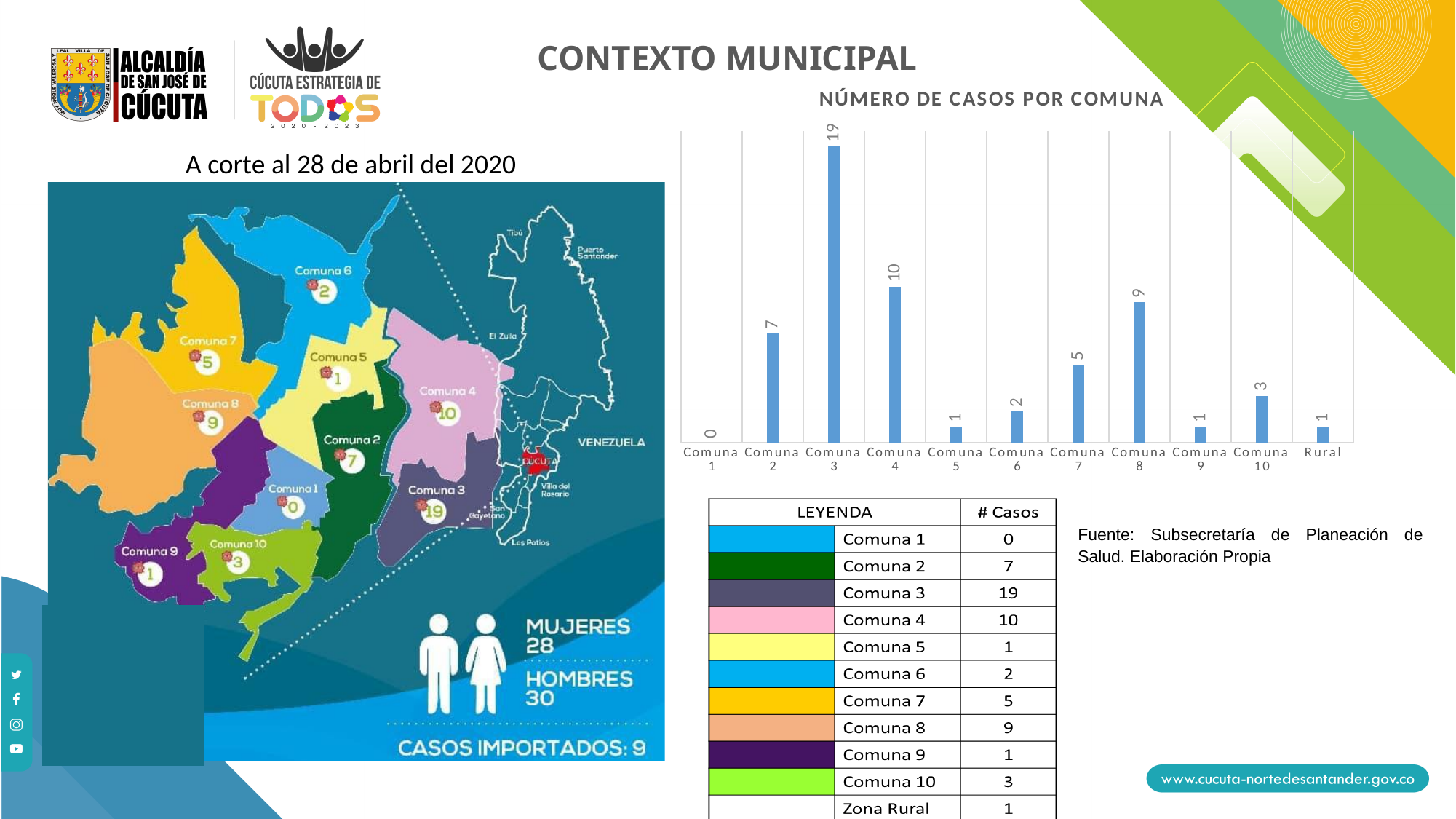
What is the difference between the values for Comuna 8 and Comuna 2 in the 'Número de casos por comuna' chart? 2 What is the difference between the values for Comuna 3 and Comuna 4 in the 'Número de casos por comuna' chart? 9 What kind of chart is the 'Número de casos por comuna' chart? Bar chart What is the value for Comuna 3 in the 'Número de casos por comuna' chart? 19 What is the value for Comuna 4 in the 'Número de casos por comuna' chart? 10 In the 'Número de casos por comuna' chart, which is larger, the value for Comuna 7 or the value for Comuna 10? Comuna 7 Which category has the highest value in the 'Número de casos por comuna' chart? Comuna 3 Which category has the lowest value in the 'Número de casos por comuna' chart? Comuna 1 How many categories are shown on the x axis of the 'Número de casos por comuna' chart? 11 What is the value for Rural in the 'Número de casos por comuna' chart? 1 In the 'Número de casos por comuna' chart, which is larger, the value for Comuna 2 or the value for Comuna 8? Comuna 8 What is the title of the chart on the right side of the slide? NÚMERO DE CASOS POR COMUNA